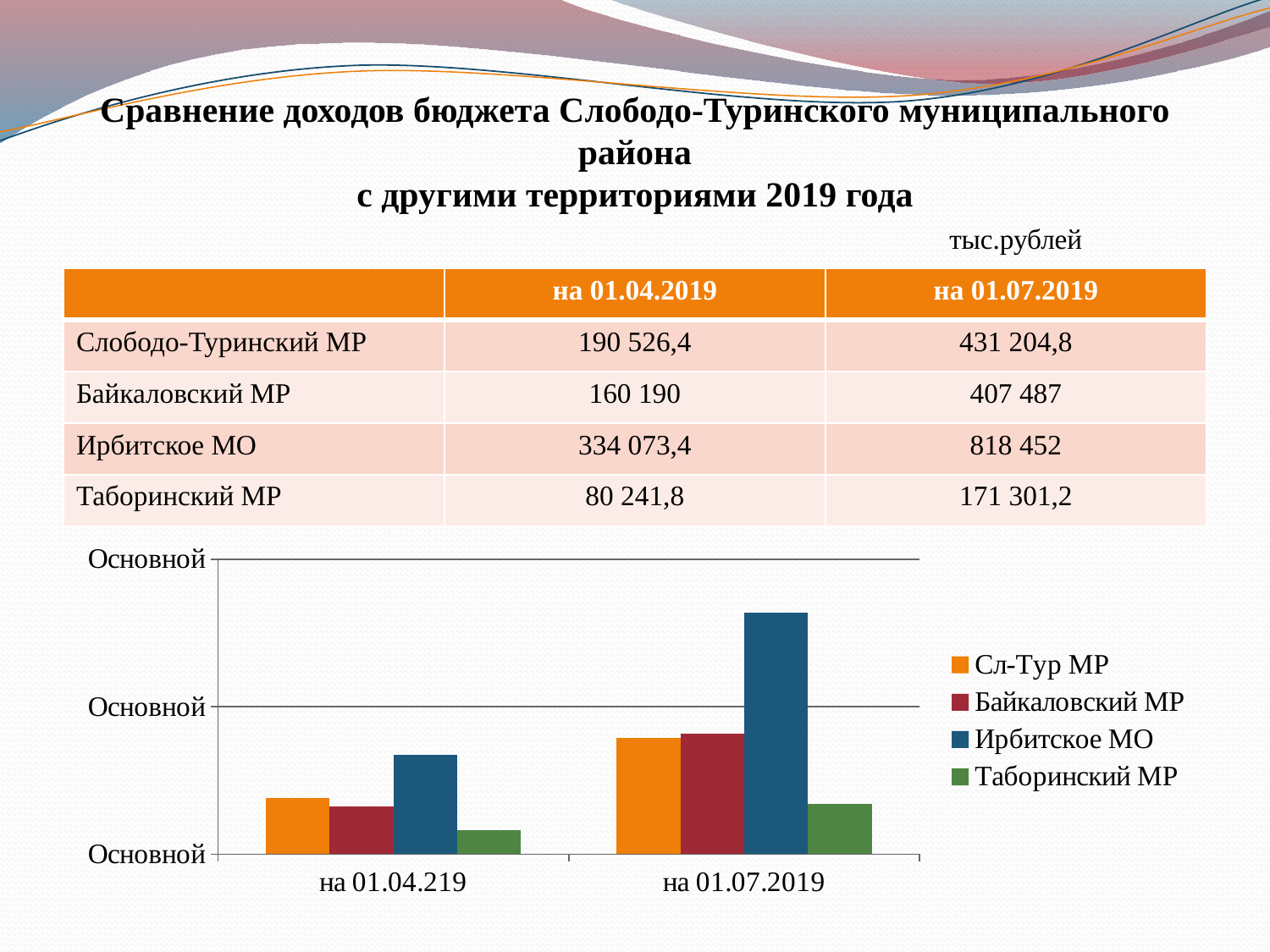
How many series does the chart legend list? 4 Which series has the tallest bar for на 01.07.2019? Ирбитское МО How many categories are shown along the x axis of the chart? 2 For на 01.04.219, which bar is taller: Сл-Тур МР or Байкаловский МР? Сл-Тур МР Do the bars for Таборинский МР rise or fall from на 01.04.219 to на 01.07.2019? rise What colour represents Ирбитское МО in the chart? blue According to the table, what is the value for Таборинский МР на 01.04.2019? 80 241,8 Which series has the tallest bar for на 01.04.219? Ирбитское МО According to the table, what is the value for Ирбитское МО на 01.07.2019? 818 452 What kind of chart is shown on the slide? bar chart What are the two category labels on the x axis of the chart? на 01.04.219 and на 01.07.2019 Which series has the shortest bar for на 01.04.219? Таборинский МР